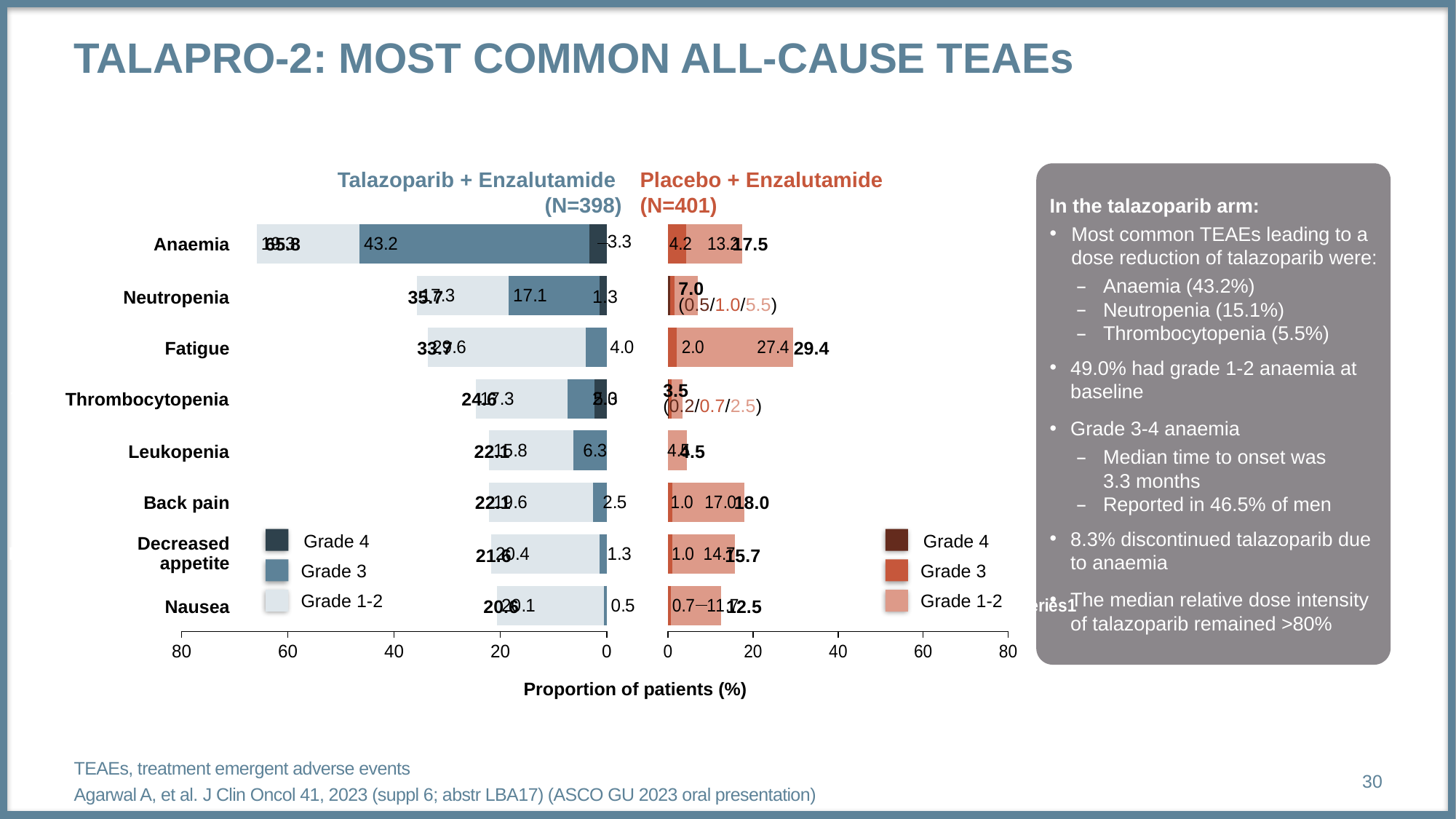
In the Placebo + Enzalutamide arm, what is the total proportion of patients with neutropenia? 7.0 In the Talazoparib + Enzalutamide arm, what is the Grade 3 proportion for anaemia? 43.2 How many adverse event categories are listed on the y axis of the chart? 8 How many grade categories does the legend list for each treatment arm? 3 In the Placebo + Enzalutamide arm, what is the total proportion of patients with back pain? 18.0 Which arm has the larger Grade 3 proportion for anaemia, Talazoparib + Enzalutamide or Placebo + Enzalutamide? Talazoparib + Enzalutamide Is the total anaemia bar for the Talazoparib + Enzalutamide arm greater or less than 60? greater In the Placebo + Enzalutamide arm, which adverse event has the highest total proportion of patients? Fatigue In the Placebo + Enzalutamide arm, what is the total proportion of patients with fatigue? 29.4 In the Placebo + Enzalutamide arm, what is the difference between the total proportion for fatigue and the total proportion for back pain? 11.4 In the Placebo + Enzalutamide arm, what is the Grade 3 proportion for anaemia? 4.2 What kind of chart is shown on the slide? bar chart